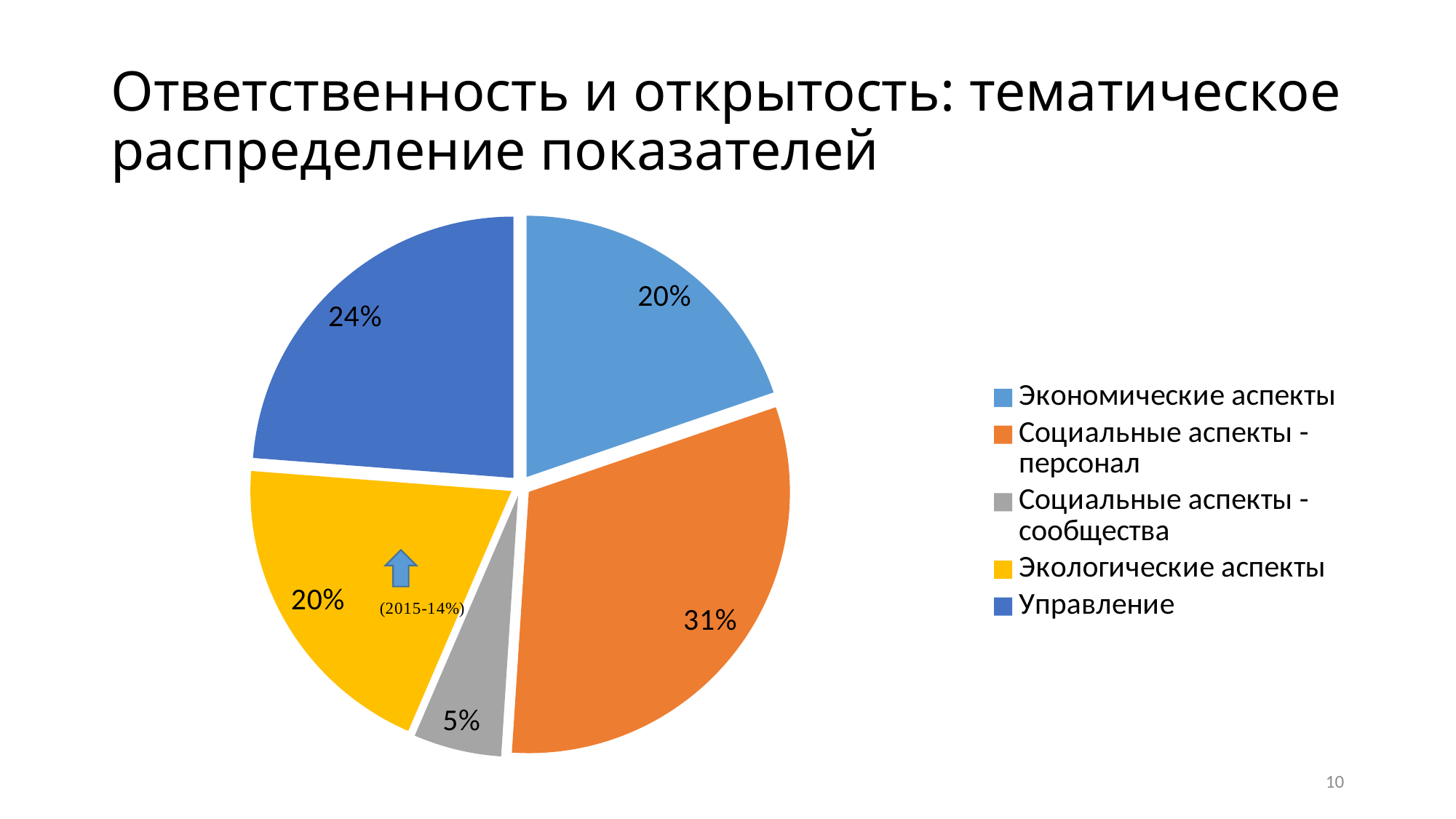
Which is larger: the slice for "Управление" or the slice for "Экономические аспекты"? Управление Which category has the smallest slice of the pie? Социальные аспекты - сообщества What is the difference in percentage points between "Социальные аспекты - персонал" and "Управление"? 7 What share of the pie does "Социальные аспекты - сообщества" have? 5% What share of the pie does "Экологические аспекты" have? 20% What kind of chart is shown on the slide? Pie chart Which category has the largest slice of the pie? Социальные аспекты - персонал What colour is the slice for "Экологические аспекты"? Yellow What share of the pie does "Социальные аспекты - персонал" have? 31% How many categories does the legend list? 5